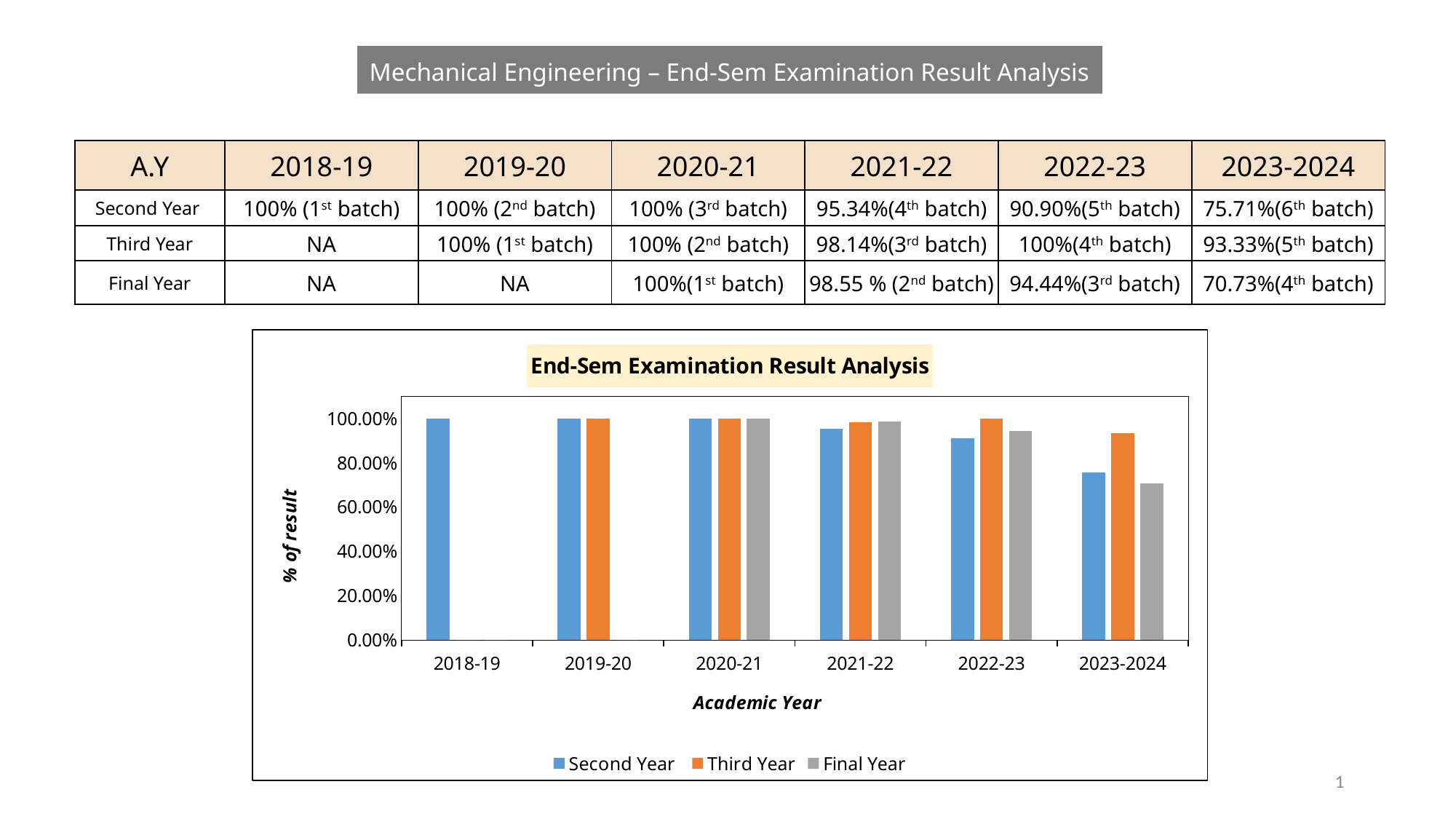
How many series does the legend of the End-Sem Examination Result Analysis chart list? 3 Do the Second Year values rise or fall from 2020-21 to 2023-2024? fall Which academic year on the chart has only a single bar? 2018-19 In which academic year is the Second Year result lowest? 2023-2024 Is the Final Year value for 2023-2024 greater or less than 80.00%? less What is the difference between the Third Year and Final Year results in 2023-2024? 22.60% How many academic years are shown on the x axis of the chart? 6 What is the title of the chart's vertical axis? % of result What type of chart is shown on the slide? bar chart What is the Second Year result for 2023-2024? 75.71% In 2023-2024, which is larger: the Third Year bar or the Second Year bar? Third Year What is the Final Year result for 2022-23? 94.44%